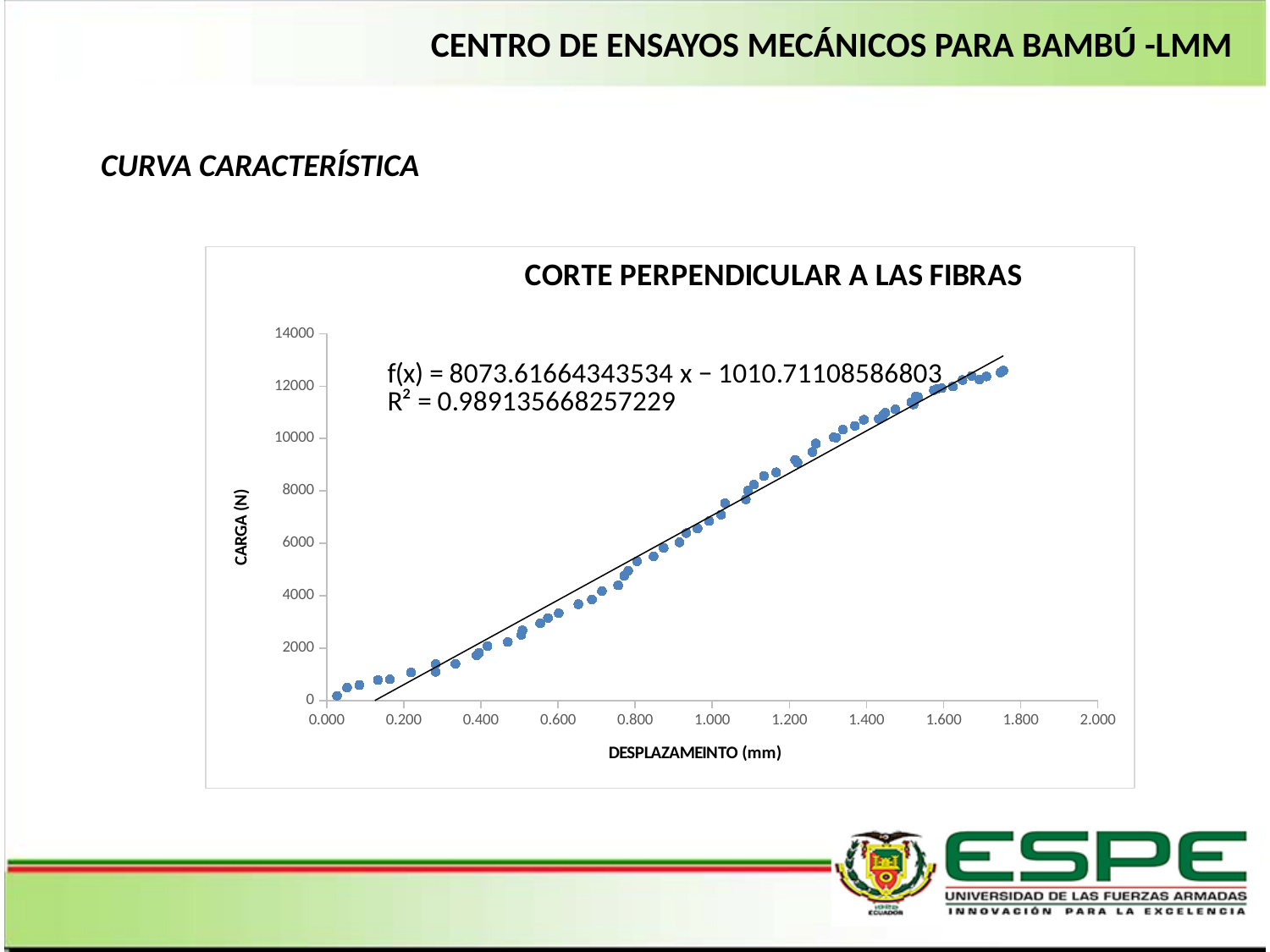
What is the slope of the fitted line f(x) printed on the chart? 8073.61664343534 What is the intercept of the fitted line f(x) printed on the chart? −1010.71108586803 Is the load at a displacement of about 1.000 mm greater or less than 6000? greater Do the plotted load values rise or fall as displacement increases along the x axis? rise What is the title of the chart? CORTE PERPENDICULAR A LAS FIBRAS Is the highest plotted load value greater or less than 12000? greater What is the highest tick value shown on the horizontal axis? 2.000 What kind of chart is shown on the slide? scatter chart Is the load at a displacement of about 0.400 mm greater or less than 4000? less What is the label of the vertical axis of the chart? CARGA (N) What is the R² value printed on the chart? 0.989135668257229 What is the highest tick value shown on the vertical axis? 14000